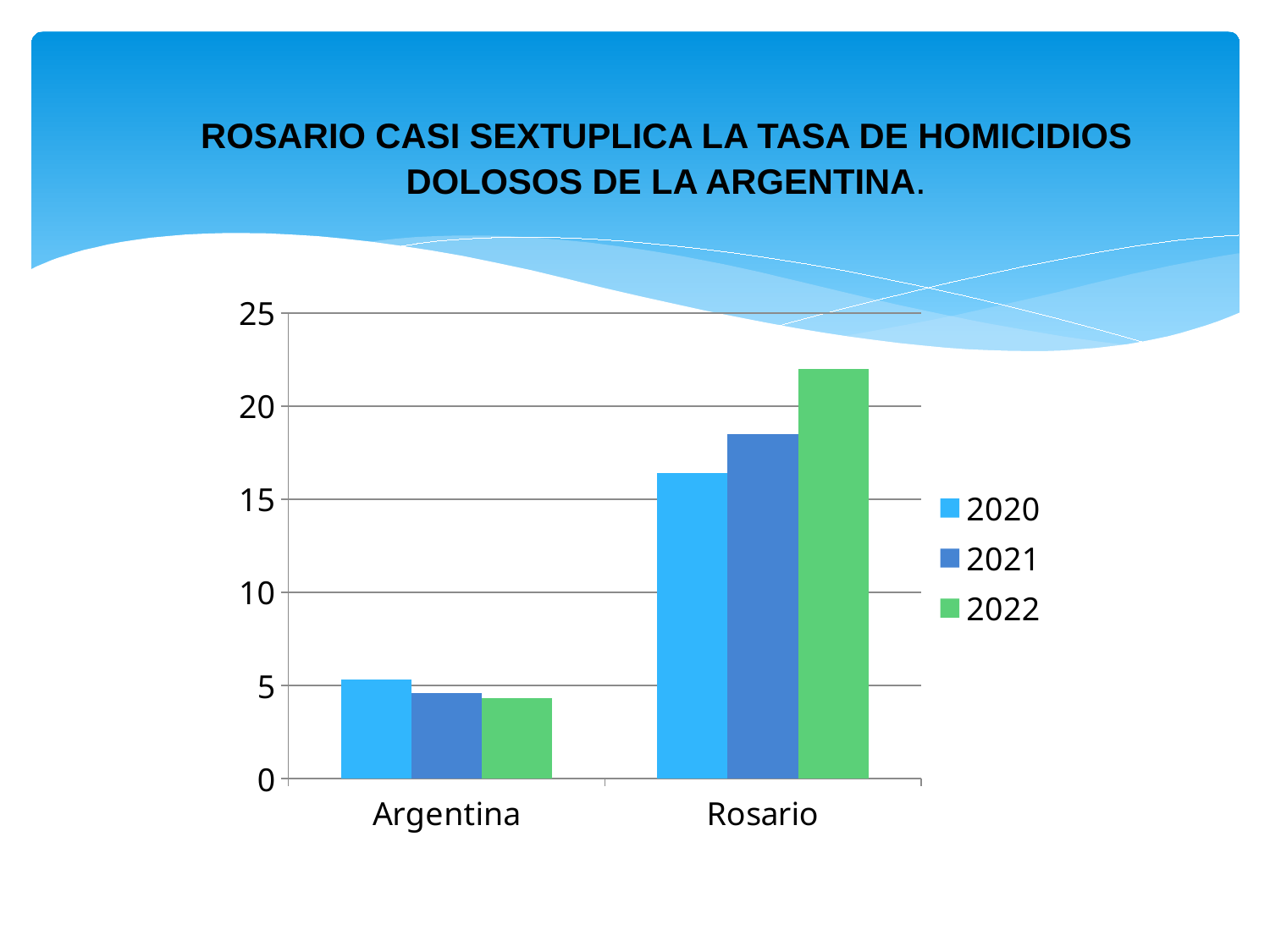
What kind of chart is shown on the slide? bar chart Which category has the lowest value for 2020? Argentina Is the value for Argentina in 2022 greater or less than 5? less Is the value for Rosario in 2022 greater or less than 20? greater Is the value for Rosario in 2020 greater or less than 15? greater Do the values for Rosario rise or fall from 2020 to 2022? rise Which series is shown in green in the legend? 2022 Which is larger for Rosario, the 2021 value or the 2022 value? 2022 Which category has the highest value for 2022? Rosario How many series does the legend list? 3 Do the values for Argentina rise or fall from 2020 to 2022? fall How many categories are shown on the x axis? 2